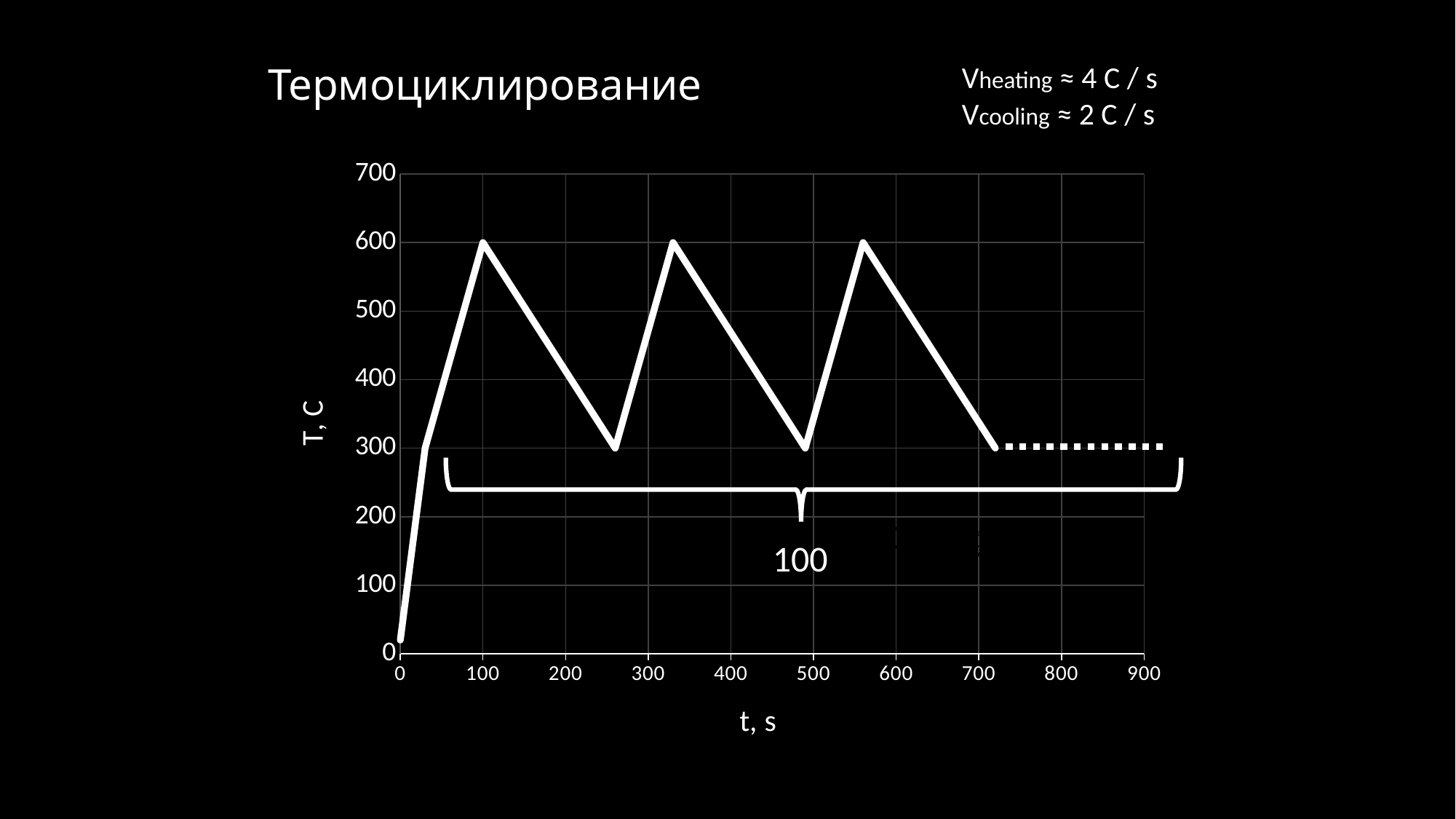
What kind of chart is shown on the slide? line chart Is the temperature at t = 600 greater or less than 400? greater Does the temperature rise or fall between t = 100 and t = 250? fall What is the highest temperature reached by the line? 600 What is the highest value shown on the y axis? 700 To what temperature does the line drop between the peaks? 300 What is the difference between the peak temperature and the trough temperature between peaks? 300 How many peaks does the temperature line have? 3 At what time does the line reach its first peak? 100 What is the label of the y axis? T, C Is the temperature at t = 200 greater or less than 500? less What is the title of the chart? Термоциклирование